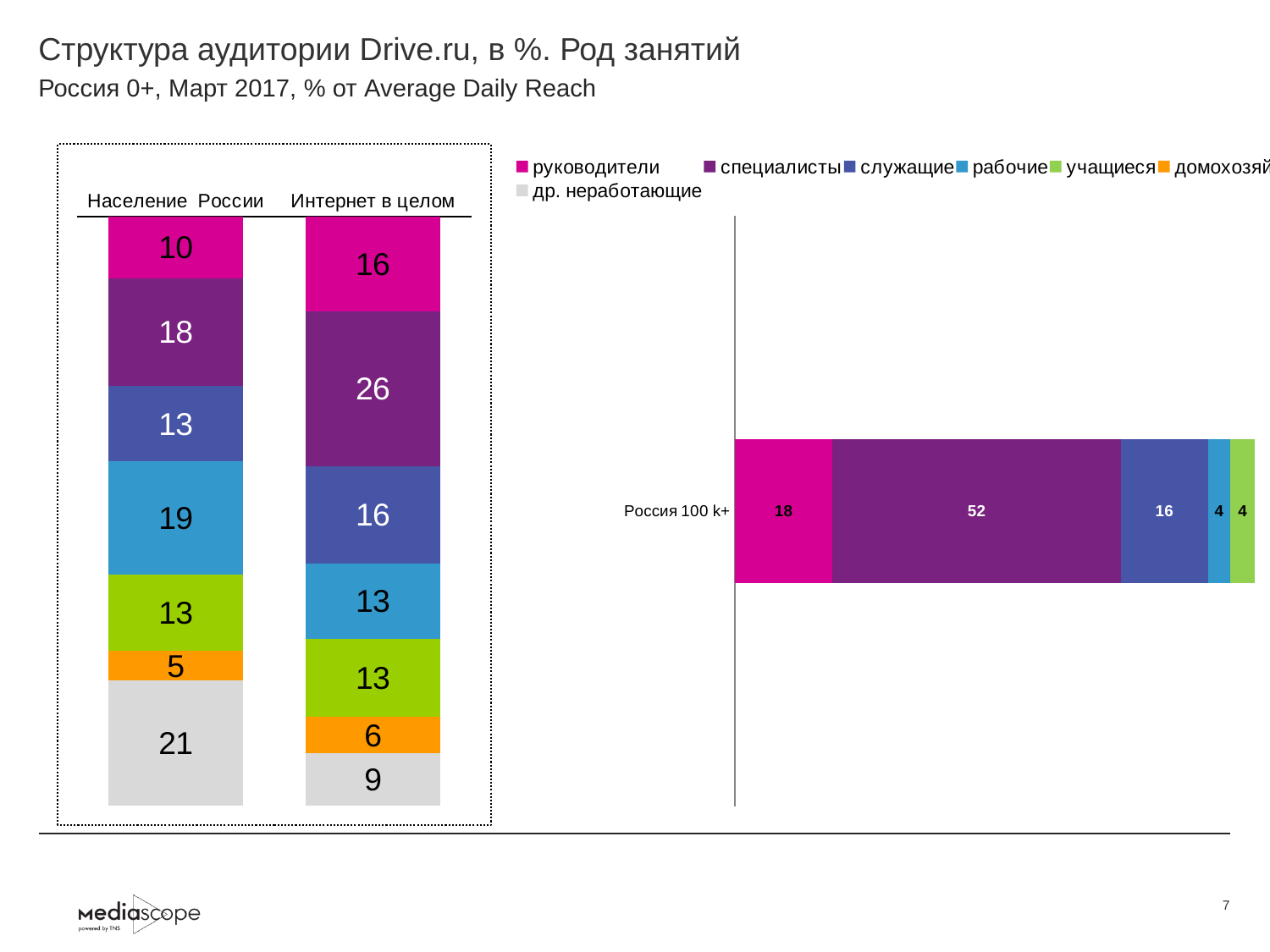
In the left-hand chart, what is the value for рабочие in the Население России bar? 19 In the right-hand chart, what is the value for руководители in the Россия 100 k+ bar? 18 In the left-hand chart, which is larger: руководители for Население России or руководители for Интернет в целом? Интернет в целом In the right-hand chart, what is the value for специалисты in the Россия 100 k+ bar? 52 In the right-hand chart, what is the difference between the специалисты and служащие values for Россия 100 k+? 36 In the left-hand chart, what is the value for специалисты in the Интернет в целом bar? 26 What kind of chart is the right-hand chart? Stacked bar chart In the right-hand chart, which segment of the Россия 100 k+ bar is the largest? специалисты In the left-hand chart, how many bars are shown? 2 How many series does the legend list? 7 In the left-hand chart, what is the difference between др. неработающие for Население России and for Интернет в целом? 12 In the left-hand chart, what is the value for др. неработающие in the Население России bar? 21